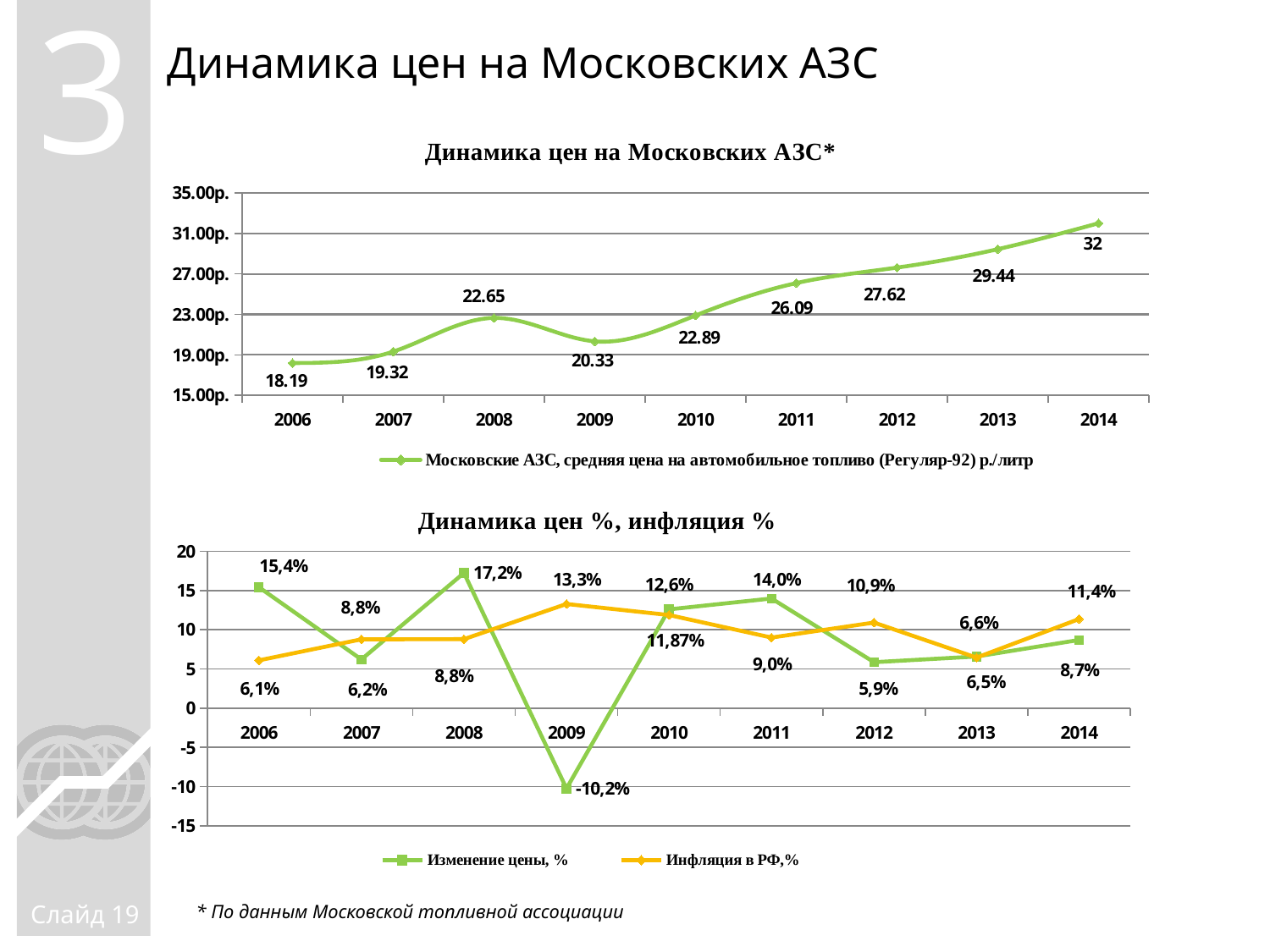
In the chart 'Динамика цен на Московских АЗС*', what kind of chart is it? line chart In the chart 'Динамика цен на Московских АЗС*', which year has the lowest value? 2006 In the chart 'Динамика цен %, инфляция %', how many series does the legend list? 2 In the chart 'Динамика цен %, инфляция %', what is the difference between 'Изменение цены, %' and 'Инфляция в РФ,%' for 2006? 9,3% In the chart 'Динамика цен %, инфляция %', what is the value of 'Инфляция в РФ,%' for 2010? 11,87% In the chart 'Динамика цен %, инфляция %', what is the value of 'Изменение цены, %' for 2009? -10,2% In the chart 'Динамика цен на Московских АЗС*', which year has the highest value? 2014 In the chart 'Динамика цен на Московских АЗС*', what is the difference between the values for 2014 and 2006? 13.81 In the chart 'Динамика цен %, инфляция %', which is larger for 2012: 'Изменение цены, %' or 'Инфляция в РФ,%'? Инфляция в РФ,% In the chart 'Динамика цен на Московских АЗС*', how many years are plotted on the x axis? 9 In the chart 'Динамика цен %, инфляция %', which year has the highest value of 'Изменение цены, %'? 2008 In the chart 'Динамика цен на Московских АЗС*', what is the value for 2008? 22.65